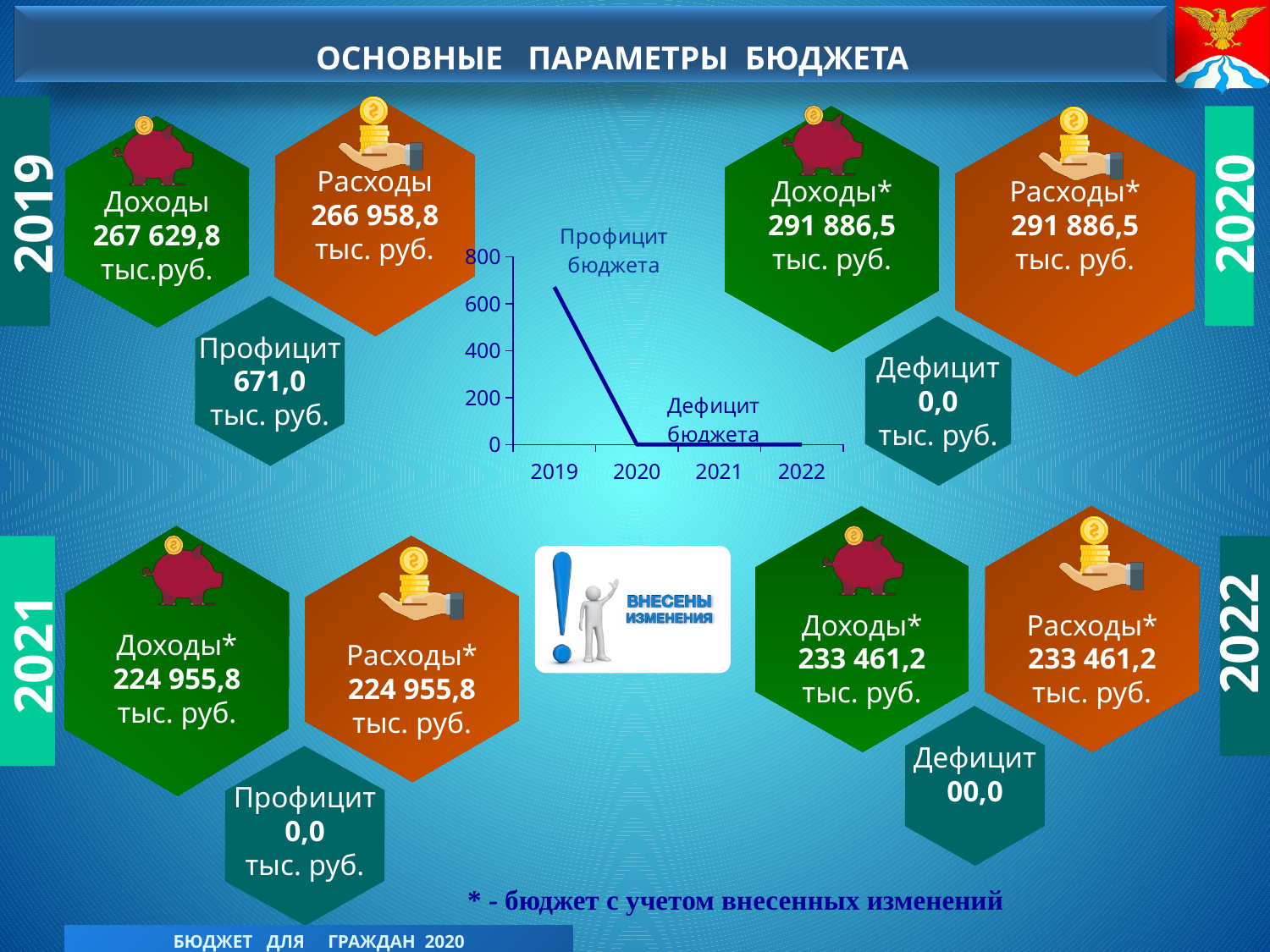
What kind of chart is shown in the centre of the slide? line chart Is the value for 2019 on the line chart greater or less than 600? greater What value does the line chart show for 2022? 0 What value does the line chart show for 2020? 0 Is the value for 2019 on the line chart greater or less than 800? less What is the highest tick value shown on the y axis of the line chart? 800 How many lines are plotted on the chart? 1 Which year has the highest value on the line chart? 2019 How many years are shown on the x axis of the line chart? 4 What label appears above the start of the line on the chart? Профицит бюджета On the line chart, which is larger: the value for 2019 or the value for 2021? 2019 Does the line in the chart rise or fall from 2019 to 2020? fall